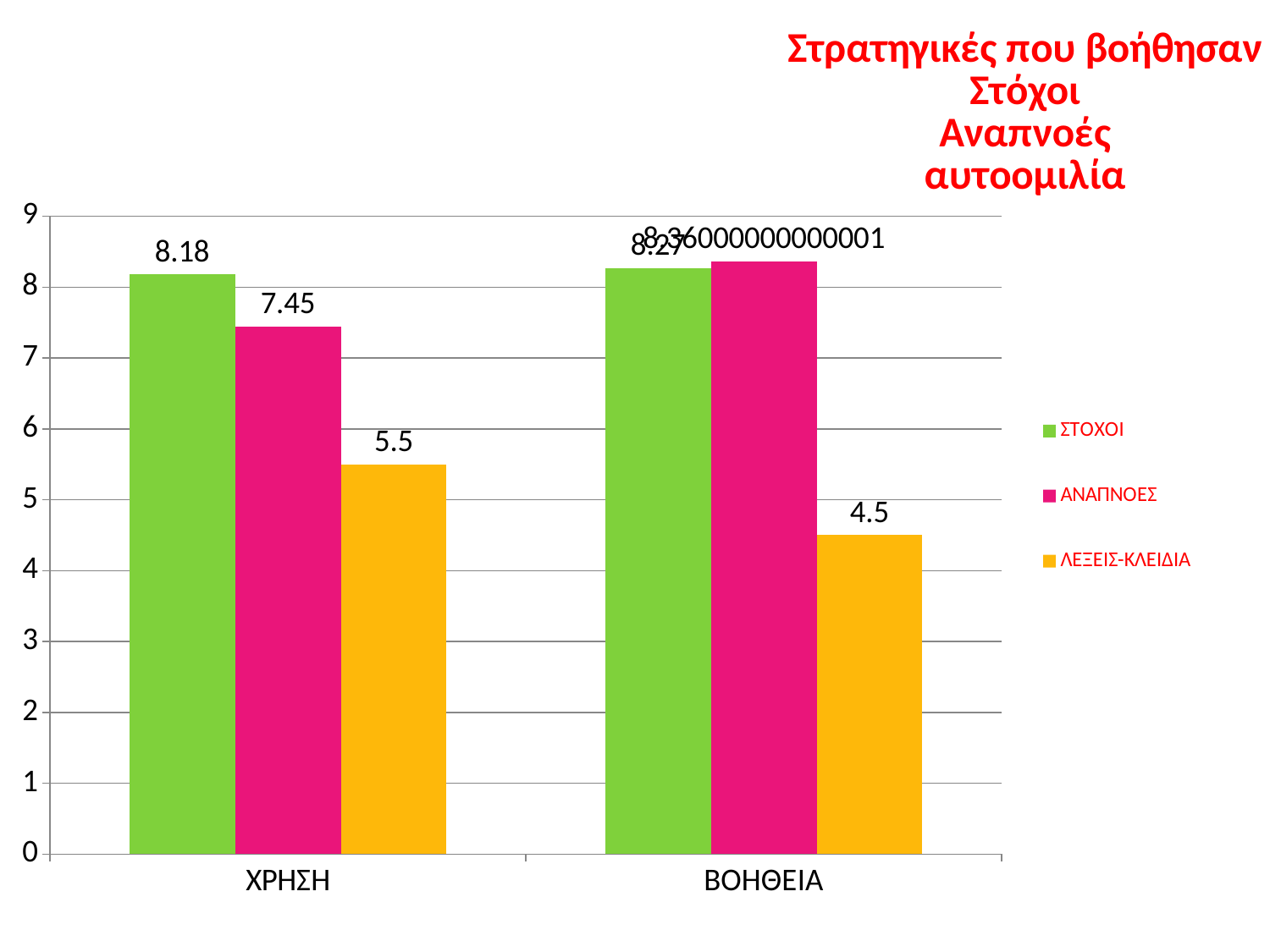
What is the value of ΣΤΟΧΟΙ for ΧΡΗΣΗ? 8.18 How many series does the legend list? 3 Which series has the lowest value for ΧΡΗΣΗ? ΛΕΞΕΙΣ-ΚΛΕΙΔΙΑ Is the value of ΑΝΑΠΝΟΕΣ for ΒΟΗΘΕΙΑ greater or less than 8? greater What is the value of ΑΝΑΠΝΟΕΣ for ΧΡΗΣΗ? 7.45 What is the value of ΛΕΞΕΙΣ-ΚΛΕΙΔΙΑ for ΧΡΗΣΗ? 5.5 What is the value of ΛΕΞΕΙΣ-ΚΛΕΙΔΙΑ for ΒΟΗΘΕΙΑ? 4.5 What is the difference between the ΛΕΞΕΙΣ-ΚΛΕΙΔΙΑ values for ΧΡΗΣΗ and ΒΟΗΘΕΙΑ? 1 Which category has the larger ΛΕΞΕΙΣ-ΚΛΕΙΔΙΑ value, ΧΡΗΣΗ or ΒΟΗΘΕΙΑ? ΧΡΗΣΗ What kind of chart is shown on the slide? bar chart What is the difference between the ΣΤΟΧΟΙ and ΑΝΑΠΝΟΕΣ values for ΧΡΗΣΗ? 0.73 Which series has the highest value for ΧΡΗΣΗ? ΣΤΟΧΟΙ